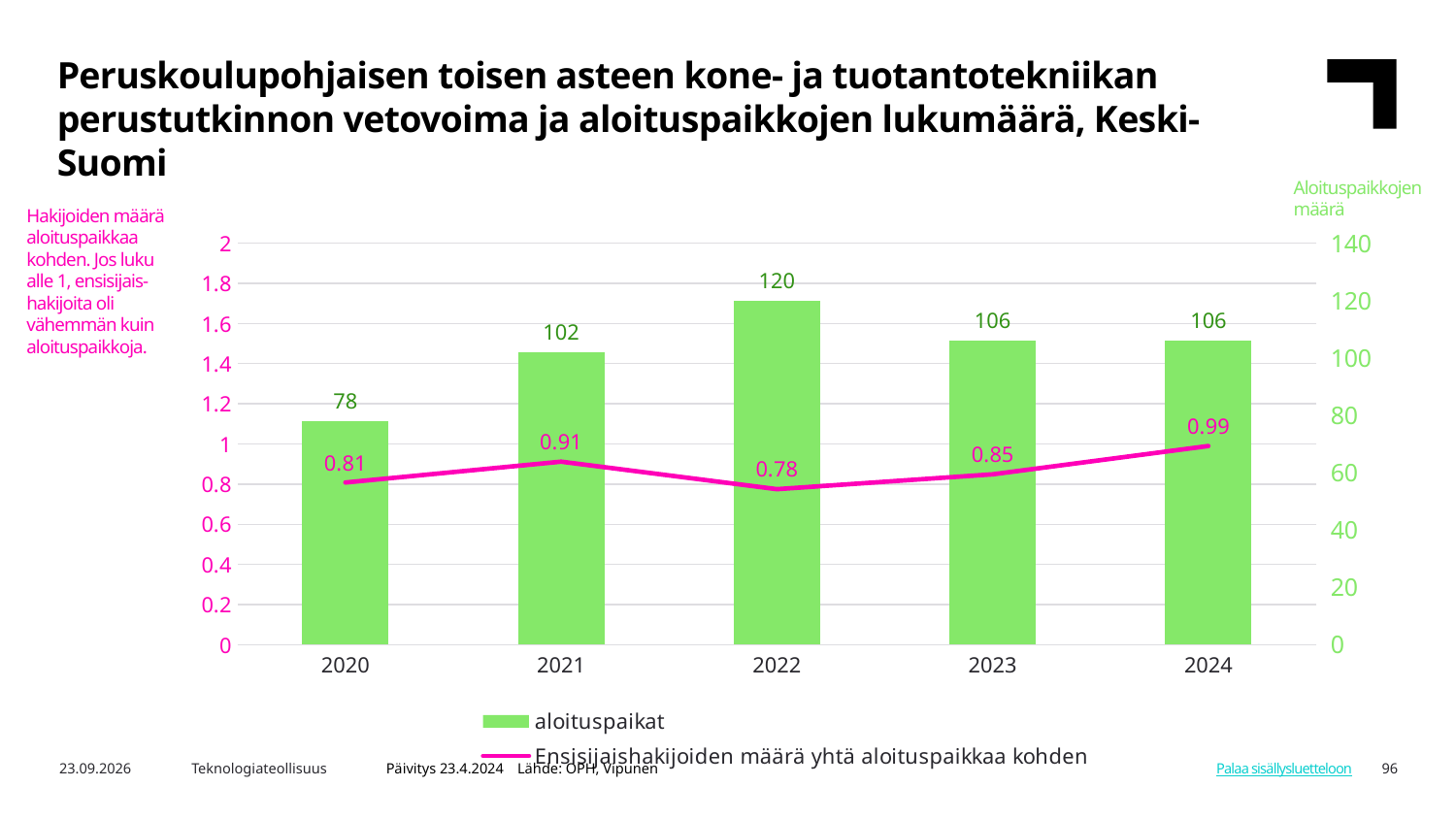
What kind of chart is shown on the slide? Combined bar and line chart Which year has the highest value of aloituspaikat? 2022 What is the difference in aloituspaikat between 2022 and 2020? 42 How many series does the legend list? 2 What is the value of aloituspaikat for 2020? 78 Does the value of aloituspaikat rise or fall from 2020 to 2022? rise Which year has a higher value of Ensisijaishakijoiden määrä yhtä aloituspaikkaa kohden, 2021 or 2023? 2021 Which year has the lowest value of Ensisijaishakijoiden määrä yhtä aloituspaikkaa kohden? 2022 What colour are the aloituspaikat bars? Green What is the value of aloituspaikat for 2022? 120 What is the value of Ensisijaishakijoiden määrä yhtä aloituspaikkaa kohden for 2024? 0.99 How many years are shown on the x axis? 5